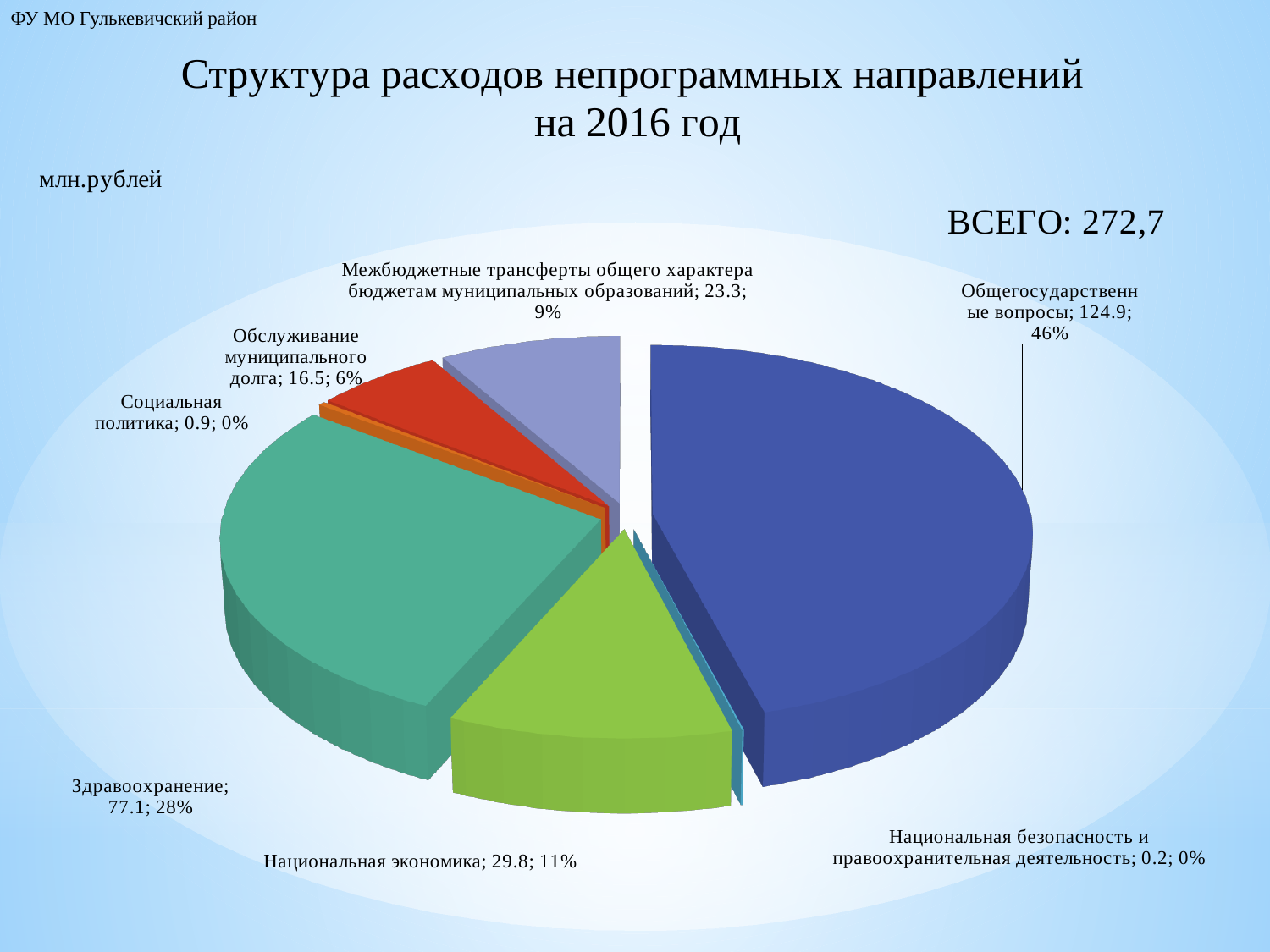
Which category has the smallest value? Национальная безопасность и правоохранительная деятельность Which category has the largest slice? Общегосударственные вопросы What is the difference between the values for Общегосударственные вопросы and Здравоохранение? 47.8 Which is larger, the value for Национальная экономика or the value for Межбюджетные трансферты общего характера бюджетам муниципальных образований? Национальная экономика What share of the pie does Межбюджетные трансферты общего характера бюджетам муниципальных образований take? 9% What total (ВСЕГО) is shown on the slide? 272,7 What kind of chart is shown on the slide? pie chart What share of the pie does Общегосударственные вопросы take? 46% What is the value for Здравоохранение? 77.1 How many slices does the pie chart have? 7 What is the value for Обслуживание муниципального долга? 16.5 What is the value for Национальная экономика? 29.8